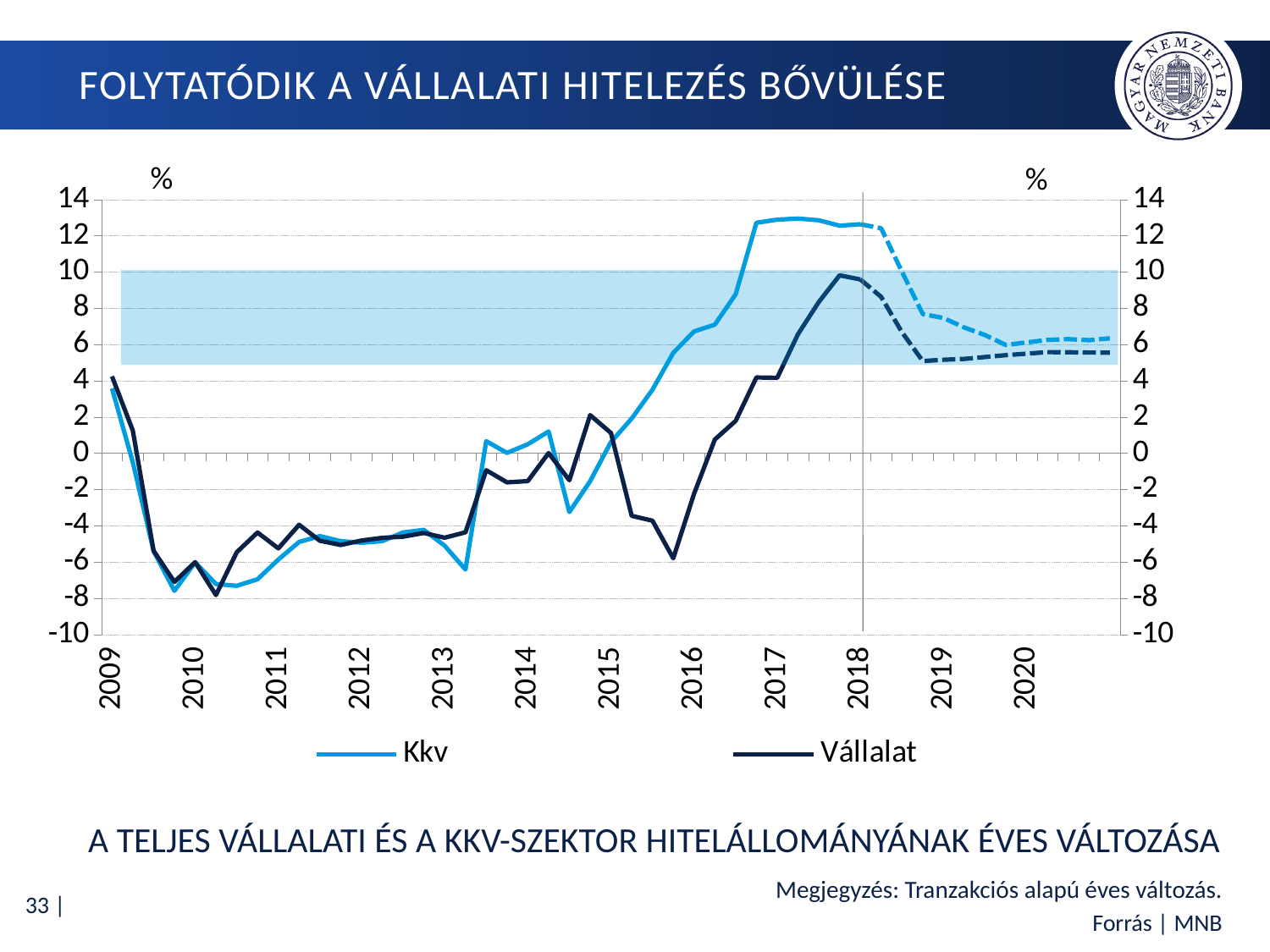
Which series reaches the highest peak on the chart? Kkv What kind of chart is shown on the slide? line chart Is the value for Vállalat at the start of 2016 greater or less than -4? greater Is the value for Vállalat at the start of 2018 greater or less than 8? greater At the start of 2010, which series has the higher value, Kkv or Vállalat? Vállalat Is the value for Kkv at the start of 2017 greater or less than 10? greater What are the two series named in the legend? Kkv and Vállalat At the start of 2017, which series has the higher value, Kkv or Vállalat? Kkv Do the Kkv values rise or fall between the start of 2016 and the start of 2017? rise How many year labels are shown on the x axis? 12 How many series does the legend list? 2